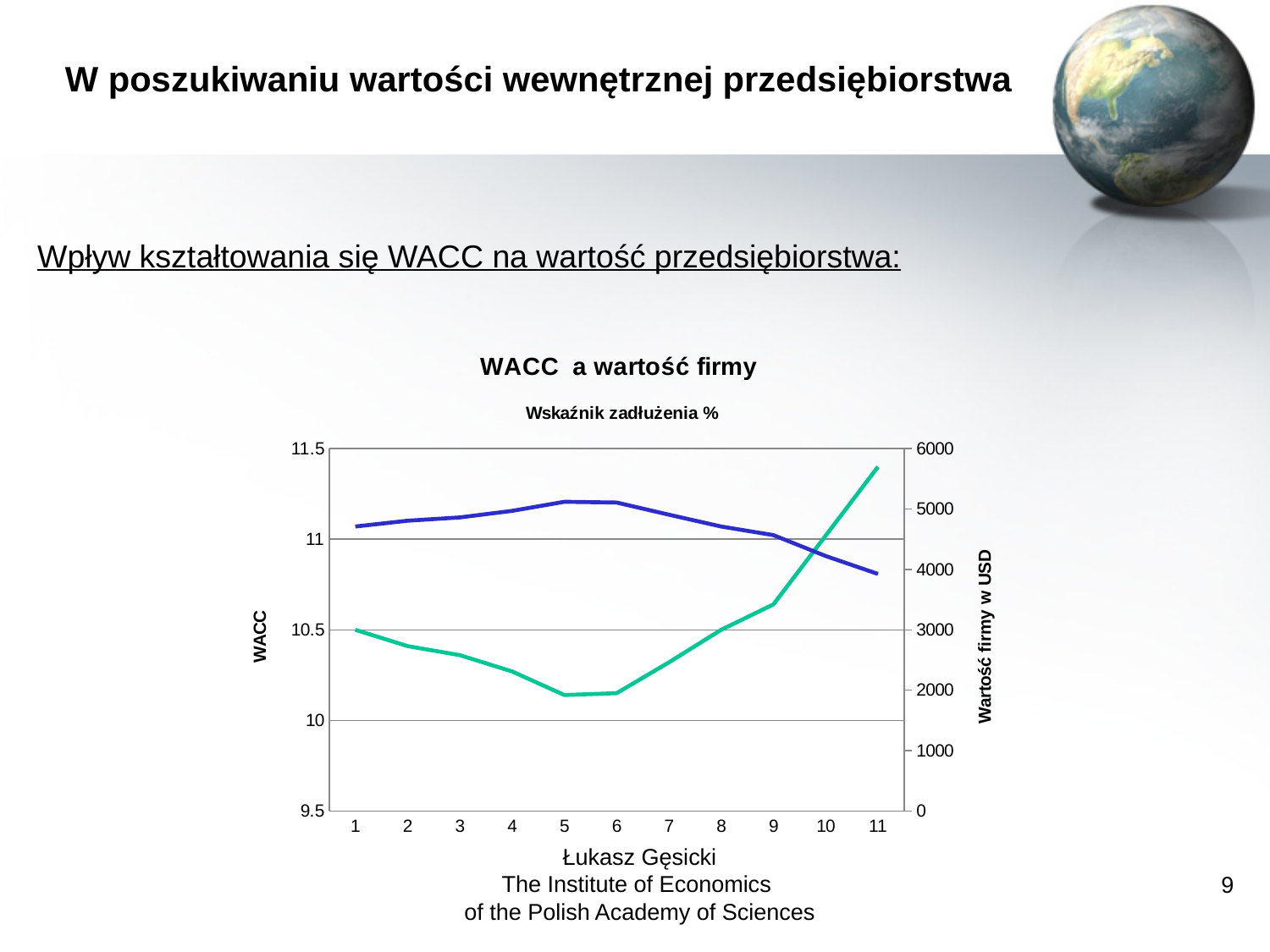
How many points are plotted along the x axis of the chart? 11 Does the blue line (left axis, WACC) rise or fall from x = 6 to x = 11? fall What is the title of the chart? WACC a wartość firmy What is the label of the right-hand vertical axis? Wartość firmy w USD What kind of chart is shown on the slide? line chart Does the green line (right axis) rise or fall from x = 6 to x = 11? rise Which is larger for the blue WACC line: the value at x = 5 or the value at x = 11? x = 5 At which x-axis point does the green line reach its highest value? 11 Does the green line (right axis) rise or fall from x = 1 to x = 5? fall